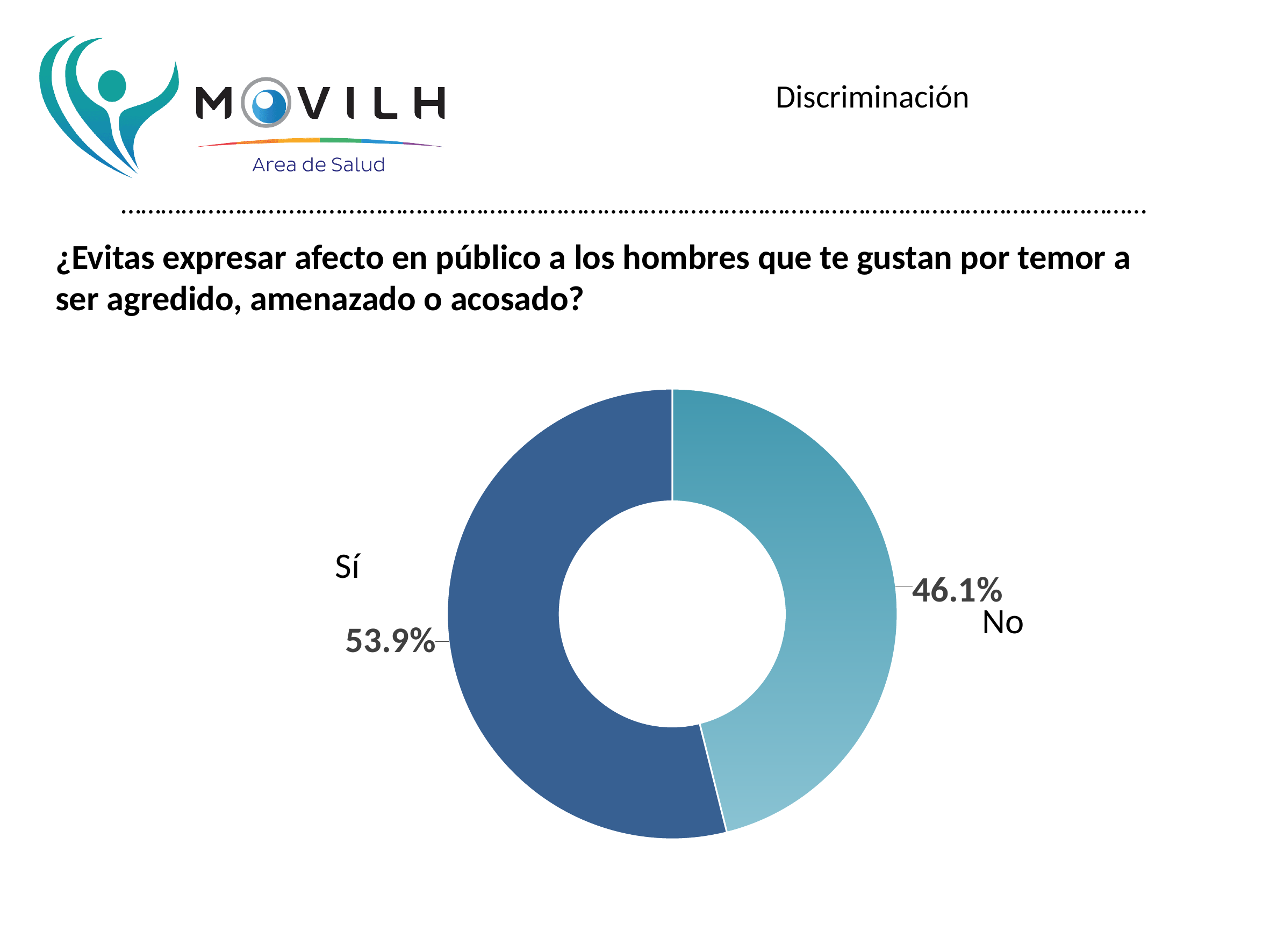
Is the share for "Sí" greater or less than 50%? greater What percentage of respondents answered "No"? 46.1% What kind of chart is shown on the slide? Doughnut (pie) chart Which category has the largest share of the chart? Sí What is the section heading shown at the top right of the slide? Discriminación Which colour represents the "Sí" segment of the chart? Dark blue Which category has the smallest share of the chart? No Is the share for "No" greater or less than 50%? less Which response has the larger share, "Sí" or "No"? Sí What is the difference in percentage points between the "Sí" and "No" shares? 7.8 How many categories are shown in the chart? 2 What percentage of respondents answered "Sí"? 53.9%